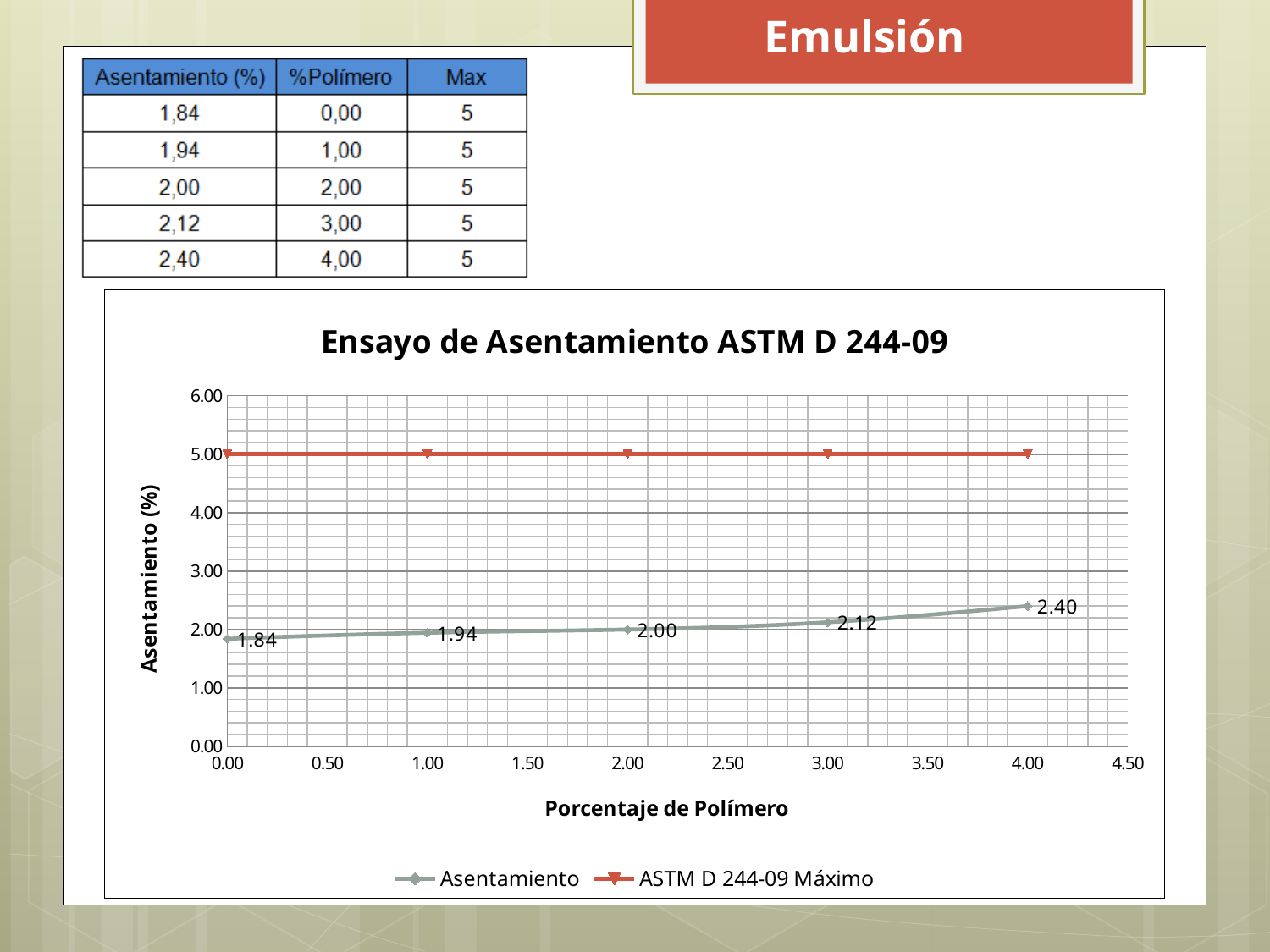
What is the title of the chart? Ensayo de Asentamiento ASTM D 244-09 What is the Asentamiento value at 2.00 Porcentaje de Polímero? 2.00 What is the Asentamiento value at 4.00 Porcentaje de Polímero? 2.40 Which is larger, the Asentamiento value at 3.00 or at 1.00 Porcentaje de Polímero? 3.00 How many series does the chart legend list? 2 Does the Asentamiento series rise or fall as Porcentaje de Polímero increases? rise What type of chart is shown on the slide? line chart At which Porcentaje de Polímero is the Asentamiento value lowest? 0.00 How many data points are plotted for the Asentamiento series? 5 What is the difference between the Asentamiento values at 4.00 and 0.00 Porcentaje de Polímero? 0.56 At which Porcentaje de Polímero is the Asentamiento value highest? 4.00 What is the Asentamiento value at 0.00 Porcentaje de Polímero? 1.84